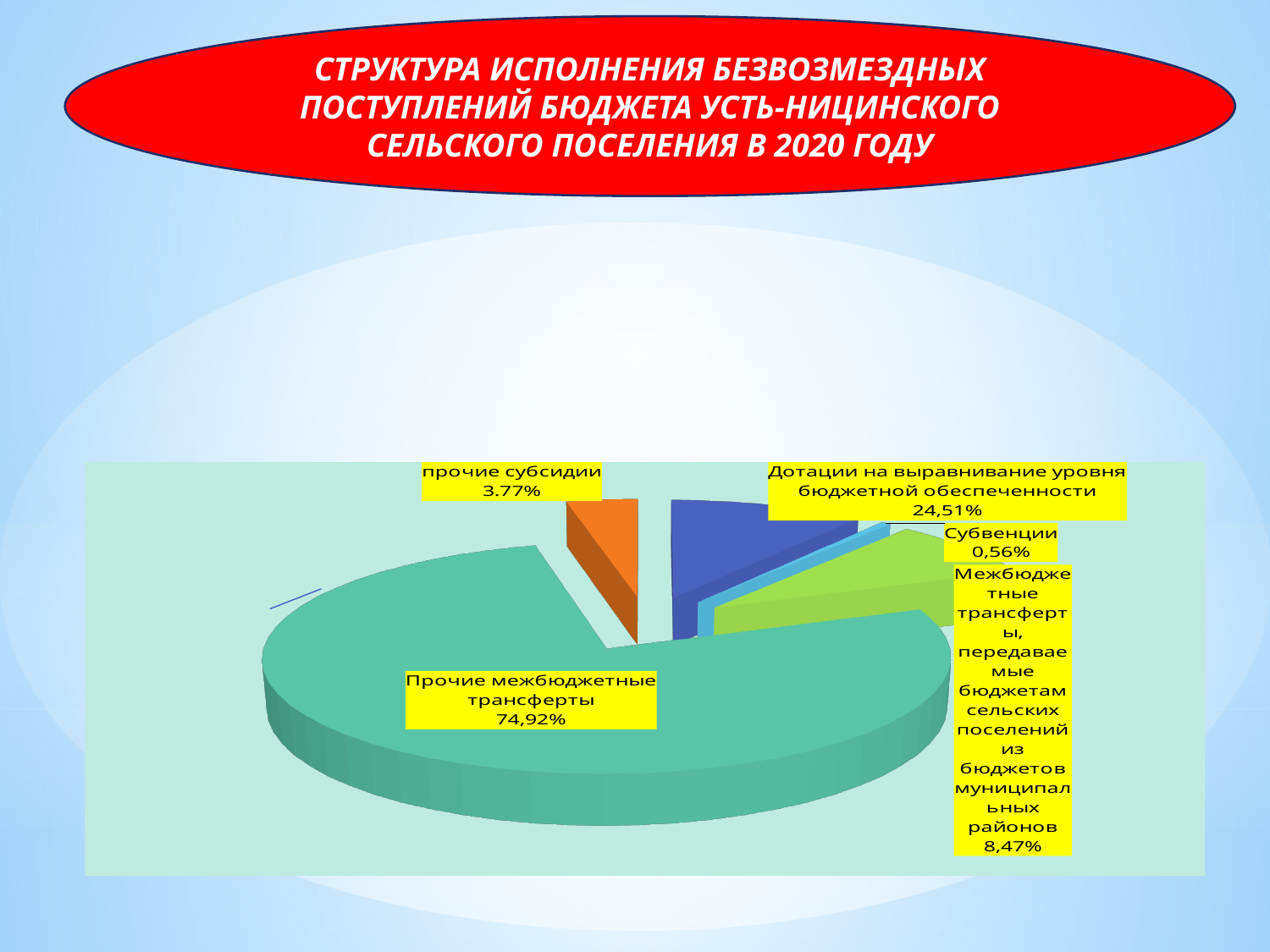
What share does "Субвенции" have in the pie chart? 0,56% How many slices does the pie chart have? 5 Which year does the chart title say the data refers to? 2020 What share does "прочие субсидии" have in the pie chart? 3.77% What kind of chart is shown on the slide? pie chart What is the difference between the share of "Прочие межбюджетные трансферты" and the share of "Дотации на выравнивание уровня бюджетной обеспеченности"? 50,41% What share does "Прочие межбюджетные трансферты" have in the pie chart? 74,92% Which is larger: the share of "Дотации на выравнивание уровня бюджетной обеспеченности" or the share of "прочие субсидии"? Дотации на выравнивание уровня бюджетной обеспеченности Which category has the largest share in the pie chart? Прочие межбюджетные трансферты What share does "Дотации на выравнивание уровня бюджетной обеспеченности" have in the pie chart? 24,51% Which category has the smallest share in the pie chart? Субвенции What share do "Межбюджетные трансферты, передаваемые бюджетам сельских поселений из бюджетов муниципальных районов" have in the pie chart? 8,47%